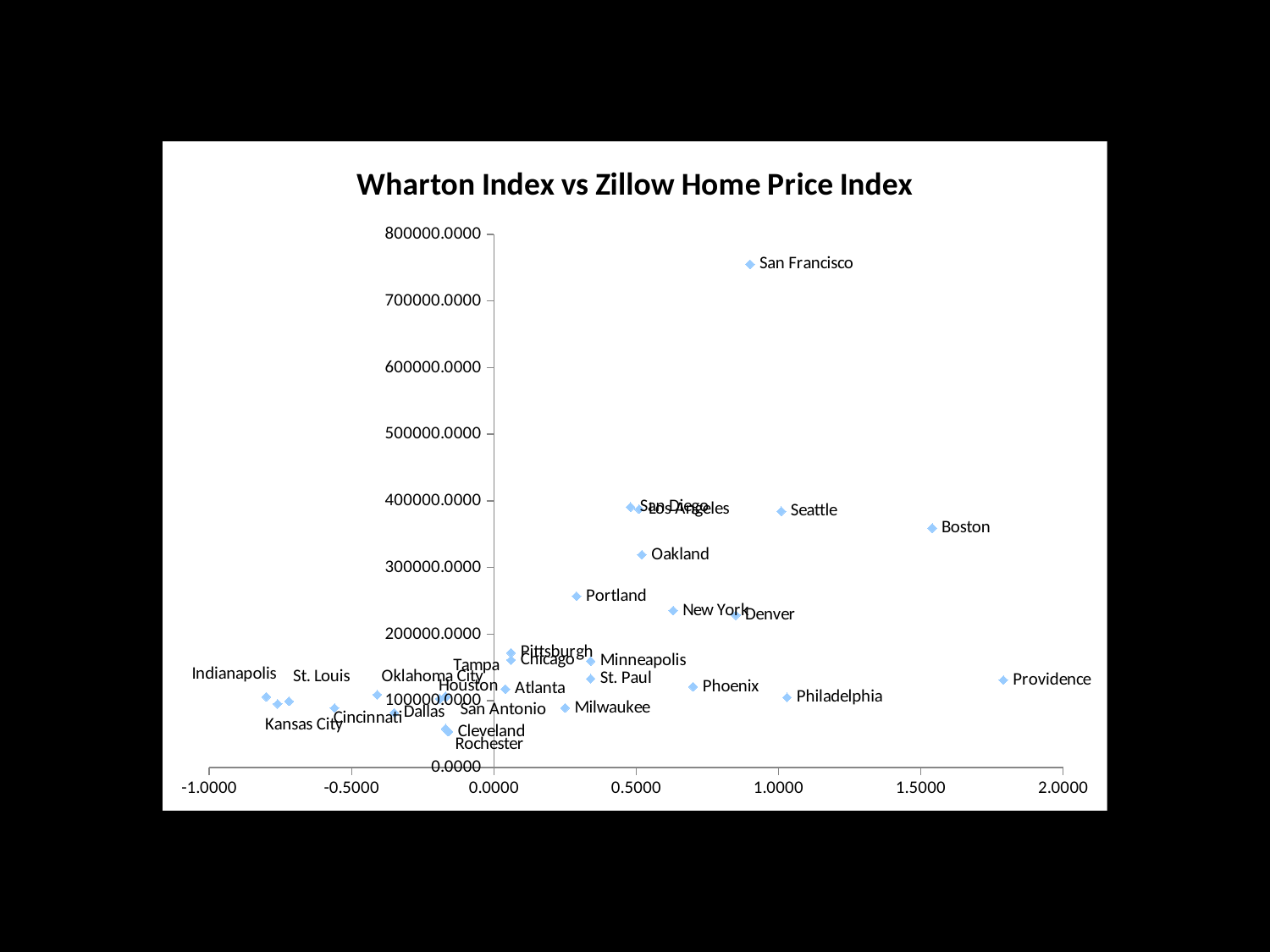
Is the Zillow Home Price Index value for Portland greater or less than 300000? less Which city has a higher Wharton Index value, Providence or Seattle? Providence Which city has the highest Zillow Home Price Index value on the chart? San Francisco Which city has the highest Wharton Index value (furthest right on the x axis)? Providence Is the Zillow Home Price Index value for Boston greater or less than 300000? greater Which city has the lowest Wharton Index value (furthest left on the x axis)? Indianapolis What kind of chart is shown on the slide? scatter chart Is the Zillow Home Price Index value for Philadelphia greater or less than 200000? less Which city has a higher Zillow Home Price Index value, San Francisco or Boston? San Francisco What is the title of the chart? Wharton Index vs Zillow Home Price Index